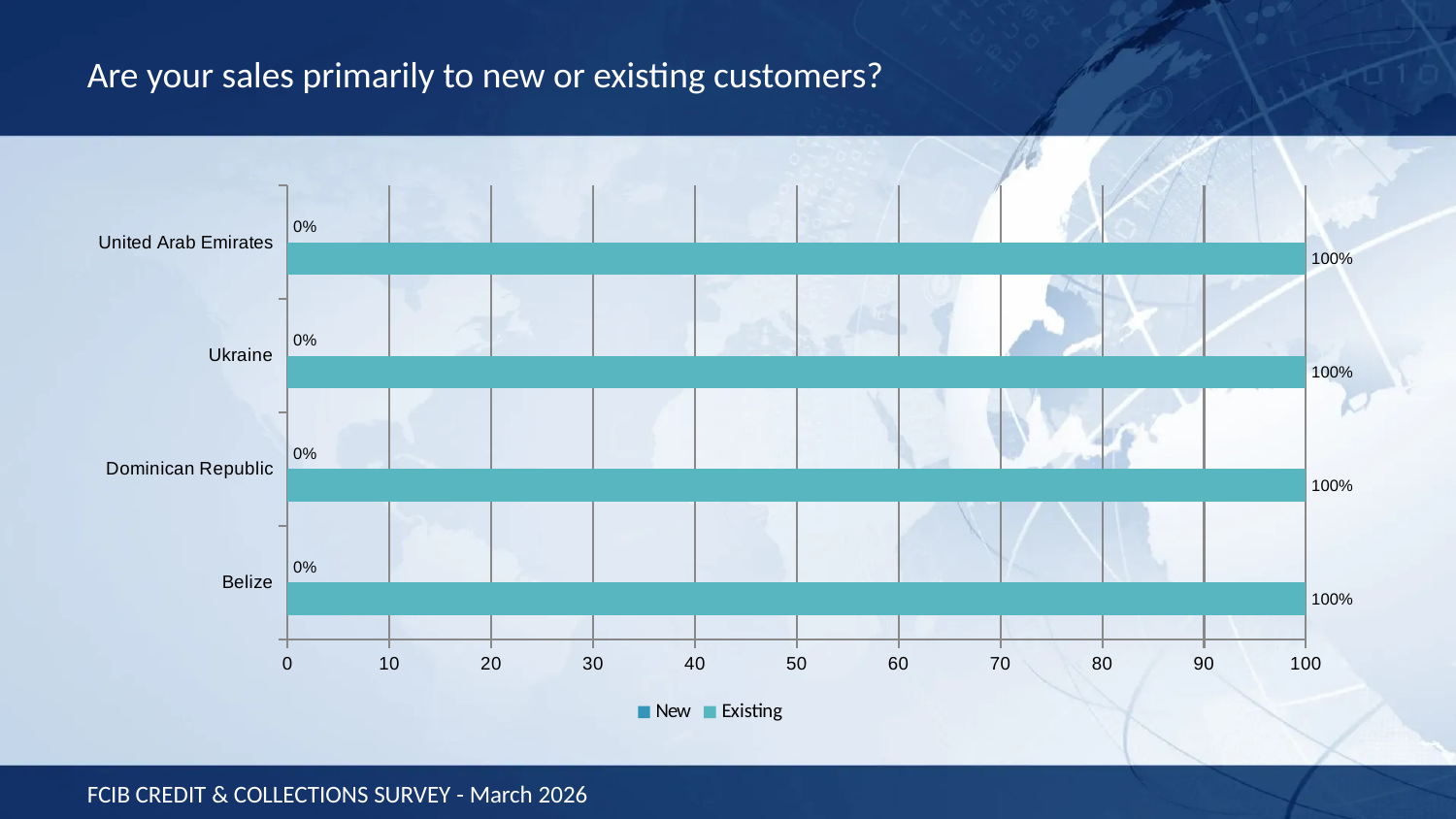
How many countries are shown on the chart? 4 What is the value for Existing customers for Ukraine? 100% What is the difference between the Existing and New values for Belize? 100% What are the two series listed in the legend? New and Existing What kind of chart is shown on the slide? Bar chart What is the value for Existing customers for the Dominican Republic? 100% What is the value for New customers for Belize? 0% Which is larger for Ukraine, the New value or the Existing value? Existing Is the Existing value for the Dominican Republic greater or less than 50? greater What is the title of the chart on the slide? Are your sales primarily to new or existing customers? What is the value for New customers for the United Arab Emirates? 0% How many series does the legend list? 2